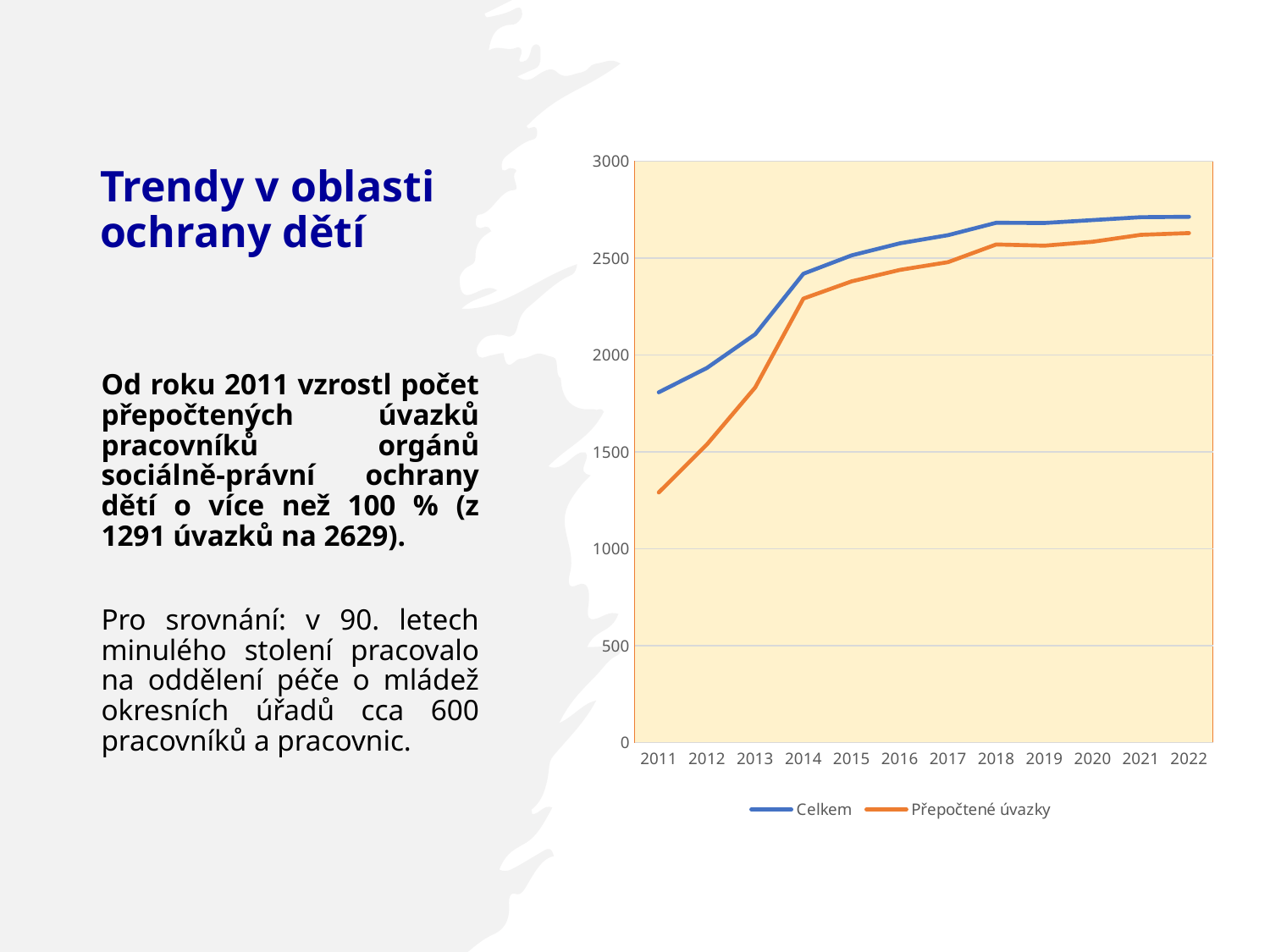
In 2011, which series has the larger value, Celkem or Přepočtené úvazky? Celkem Is the value for Celkem in 2022 greater or less than 2500? greater Is the value for Přepočtené úvazky in 2011 greater or less than 1500? less In which year is the Přepočtené úvazky series at its lowest? 2011 Is the value for Celkem in 2011 greater or less than 1500? greater In which year is the Celkem series at its lowest? 2011 How many years are plotted along the x axis of the chart? 12 What kind of chart is shown on the slide? line chart How many series does the chart legend list? 2 Which series is shown in orange in the chart? Přepočtené úvazky Do the values of the Celkem series rise or fall from 2011 to 2022? rise